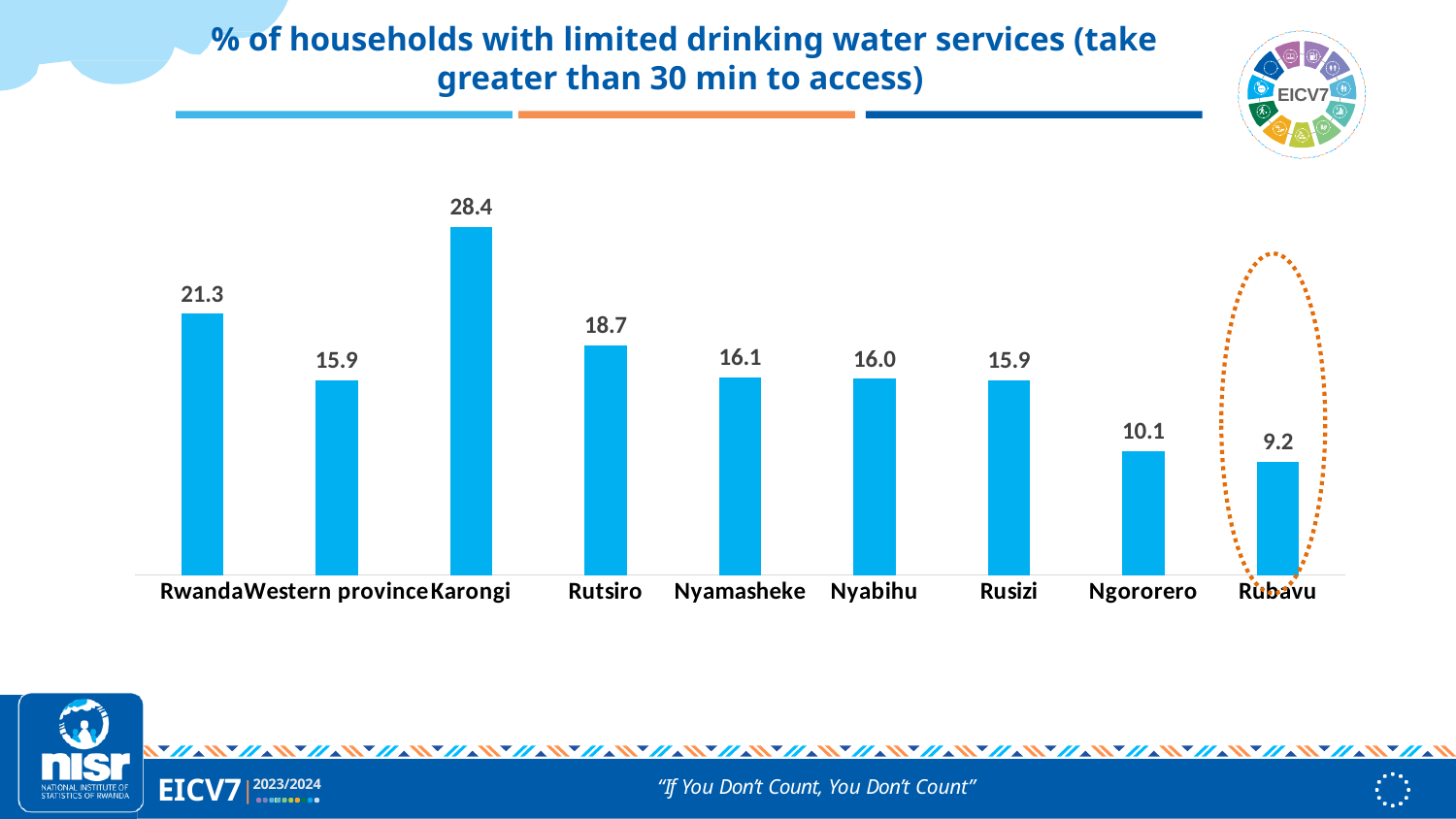
Which is larger, the value for Rutsiro or the value for Nyamasheke? Rutsiro What is the value for Ngororero? 10.1 What kind of chart is shown on the slide? Bar chart What is the value for Rubavu? 9.2 What is the difference between the values for Karongi and Rubavu? 19.2 Which category has the highest value? Karongi What is the value for Rwanda? 21.3 Which category has the lowest value? Rubavu What is the value for Karongi? 28.4 How many categories are shown on the chart? 9 What is the difference between the values for Rwanda and Western province? 5.4 What is the title of the chart? % of households with limited drinking water services (take greater than 30 min to access)